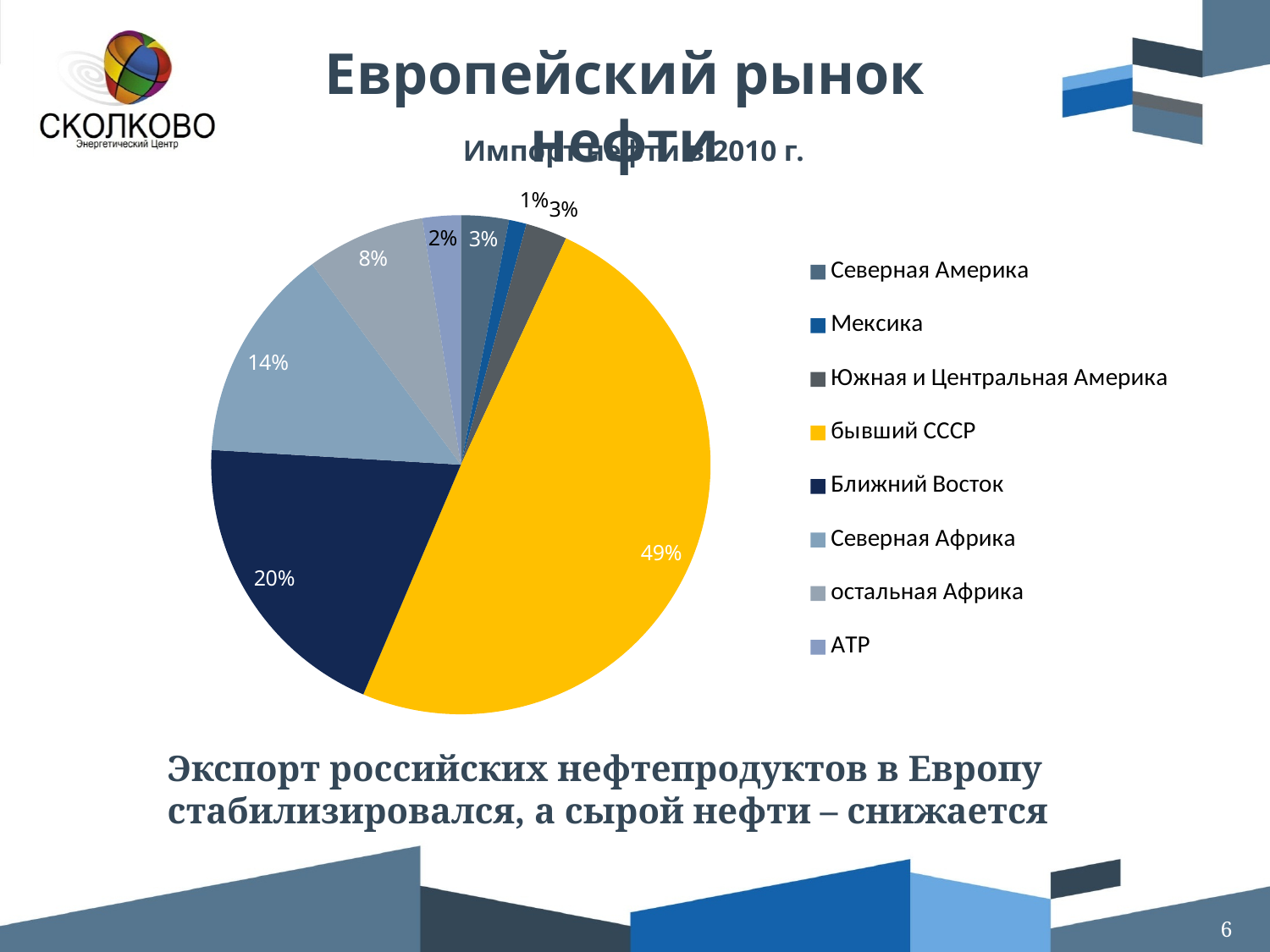
Which category has the smallest slice of the pie? Мексика Which has a larger share, Северная Африка or остальная Африка? Северная Африка What share of the pie does АТР hold? 2% What share of the pie does Ближний Восток hold? 20% How many categories does the legend list? 8 Which category has the largest slice of the pie? бывший СССР What share of the pie does Мексика hold? 1% What share of the pie does остальная Африка hold? 8% What share of the pie does бывший СССР hold? 49% What share of the pie does Северная Африка hold? 14% What is the difference in percentage points between the shares of бывший СССР and Ближний Восток? 29 What type of chart is shown on the slide? pie chart